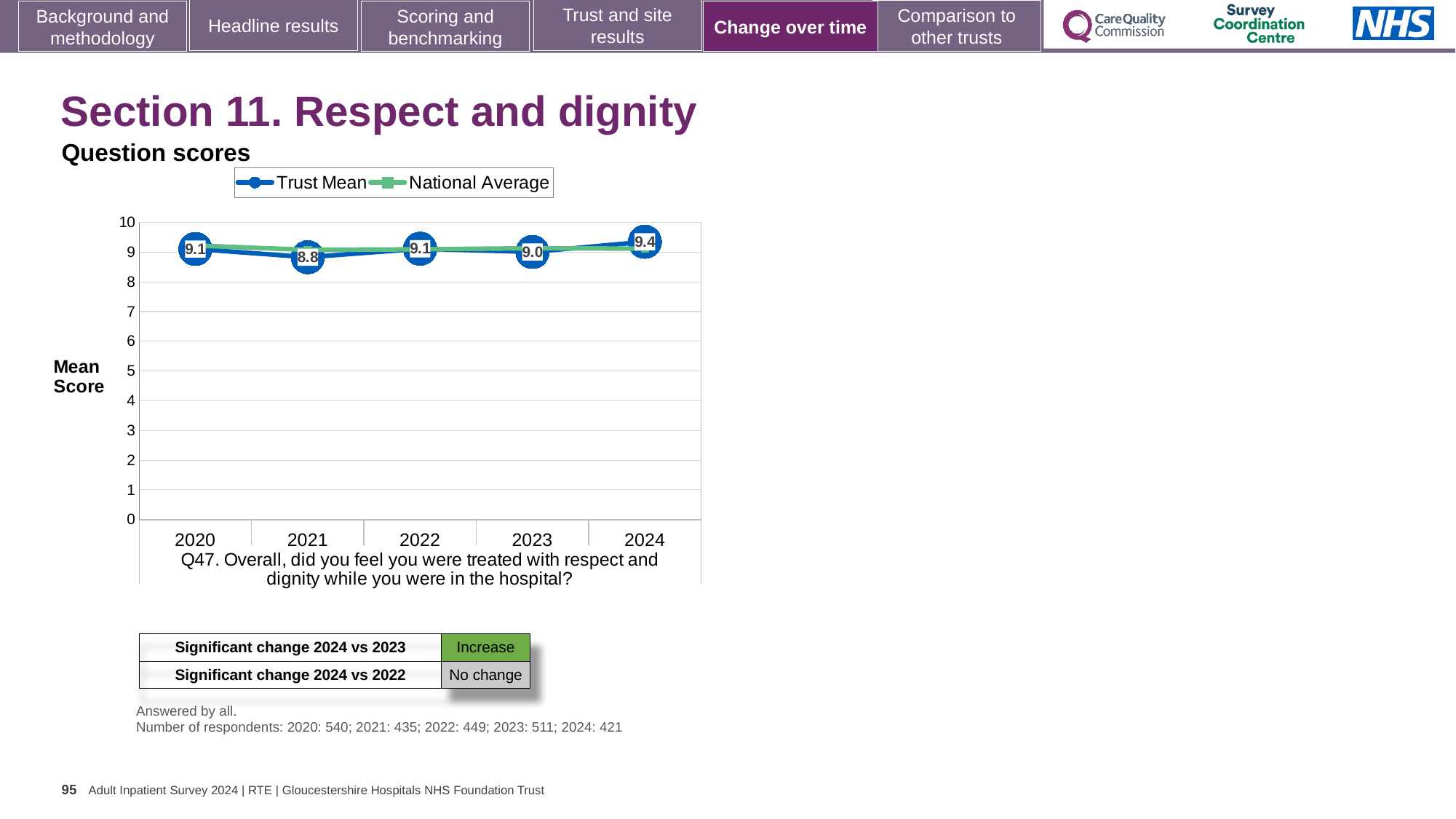
How many years are plotted on the x axis? 5 What is the Trust Mean score for 2024? 9.4 How many series does the legend list? 2 What is the difference between the Trust Mean scores for 2024 and 2021? 0.6 In which year is the Trust Mean score highest? 2024 Does the Trust Mean score rise or fall from 2023 to 2024? Rise In which year is the Trust Mean score lowest? 2021 What is the Trust Mean score for 2023? 9.0 Is the National Average value for 2022 greater or less than 8? greater What kind of chart is shown on the slide? Line chart Which year has the larger Trust Mean score, 2023 or 2024? 2024 What is the Trust Mean score for 2021? 8.8